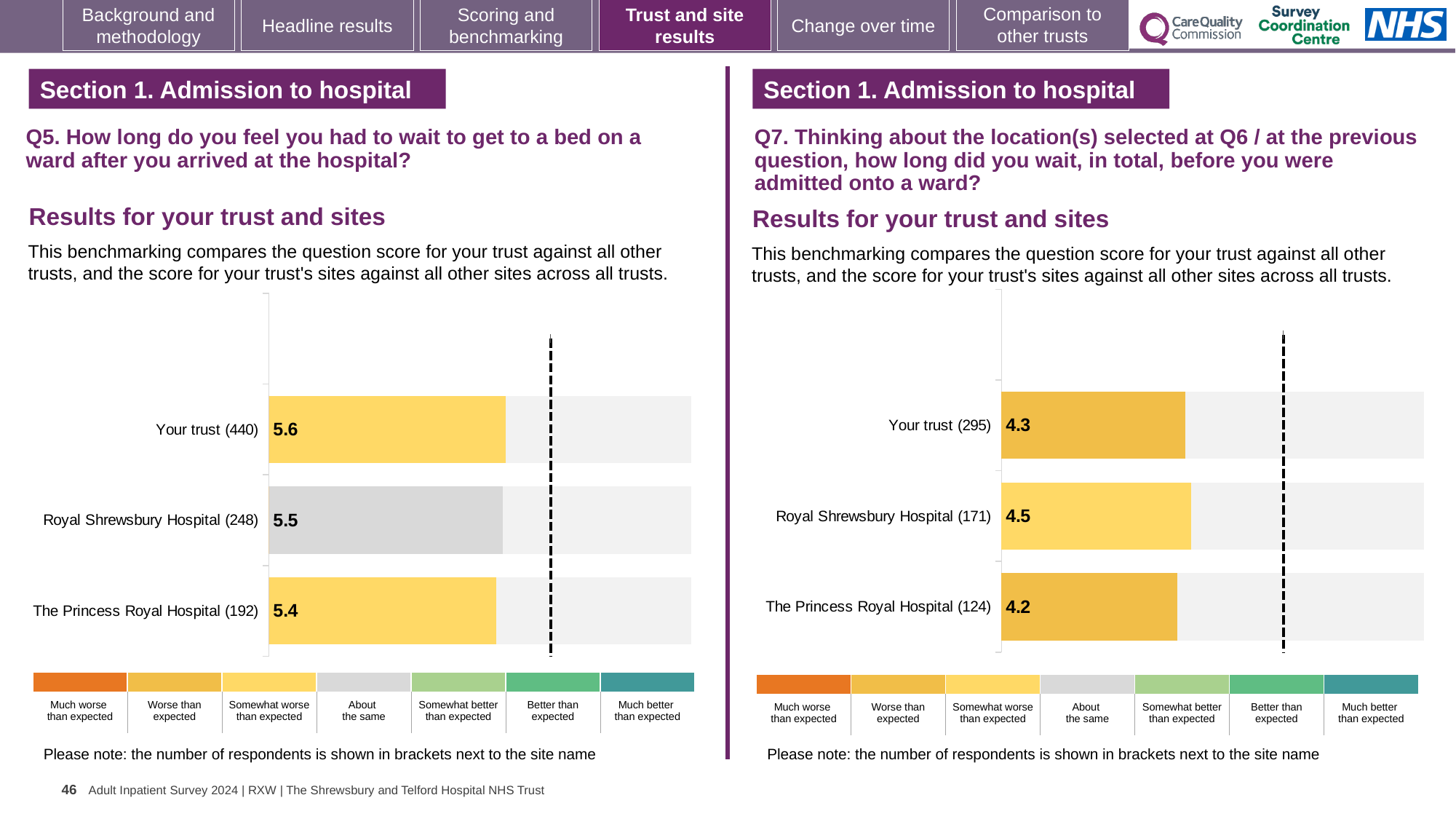
In the Q7 chart on the right, which site or trust has the highest score? Royal Shrewsbury Hospital In the Q7 chart on the right, what is the score for The Princess Royal Hospital? 4.2 In the Q7 chart on the right, what is the difference between the score for Royal Shrewsbury Hospital and the score for Your trust? 0.2 In the Q7 chart on the right, what is the score for Royal Shrewsbury Hospital? 4.5 What type of chart is used in the Q7 chart on the right? Bar chart In the Q5 chart on the left, how many respondents are shown in brackets for Royal Shrewsbury Hospital? 248 In the Q5 chart on the left, what is the score for Your trust? 5.6 How many bars are plotted in the Q5 chart on the left? 3 In the Q5 chart on the left, which site or trust has the lowest score? The Princess Royal Hospital In the Q5 chart on the left, what is the score for The Princess Royal Hospital? 5.4 In the Q5 chart on the left, what is the difference between the score for Your trust and the score for The Princess Royal Hospital? 0.2 In the Q7 chart on the right, which has the larger score, Your trust or The Princess Royal Hospital? Your trust